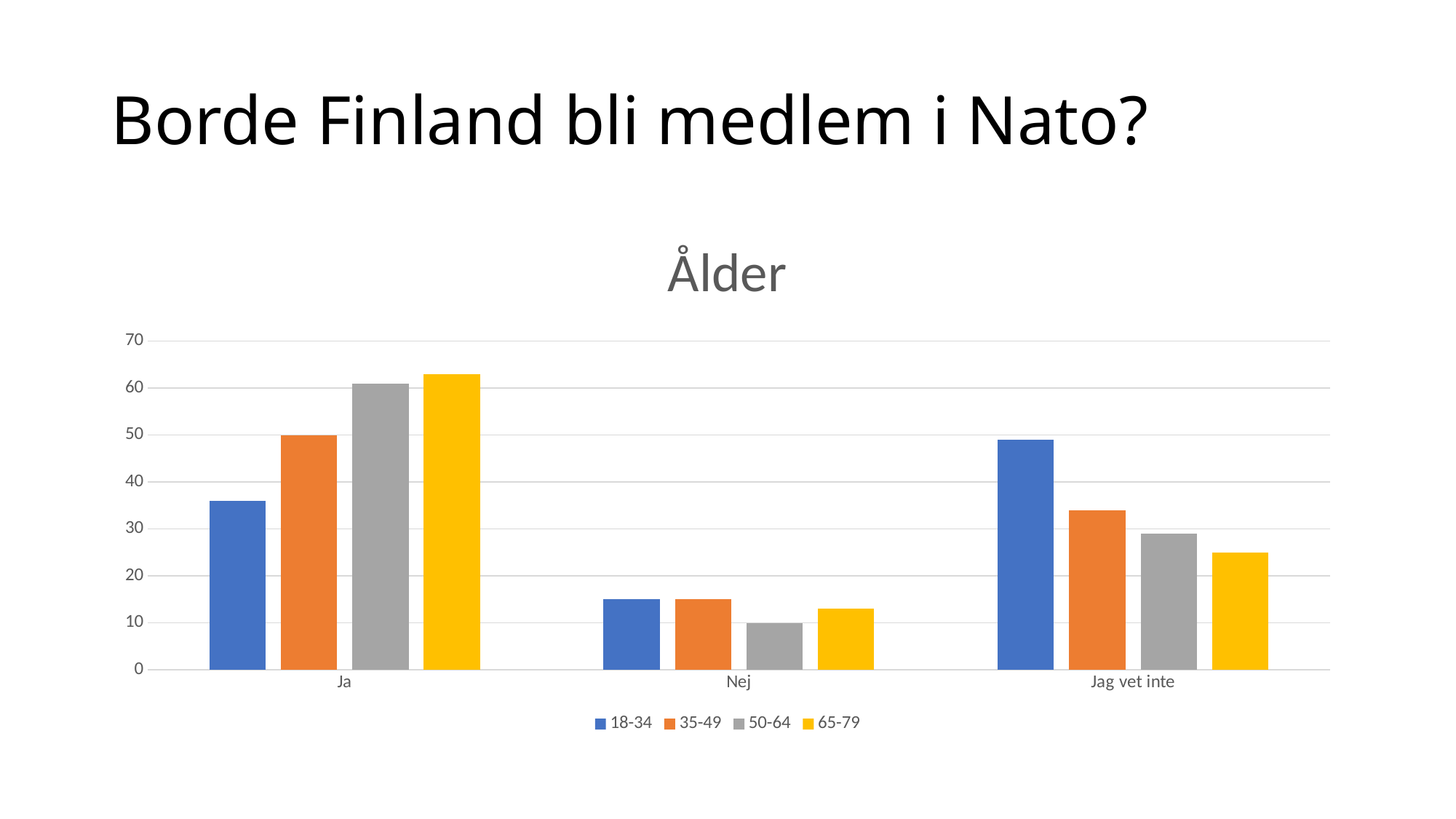
Which age group has the highest value in the Jag vet inte category? 18-34 Is the value for the 18-34 series in the Jag vet inte category greater or less than 40? greater Is the value for the 65-79 series in the Nej category greater or less than 20? less What is the value for the 50-64 series in the Nej category? 10 Which age group has the highest value in the Ja category? 65-79 In the Jag vet inte category, which is larger: the value for 35-49 or the value for 65-79? 35-49 How many series does the legend list? 4 How many categories are shown on the x axis? 3 What is the title of the chart? Ålder What is the value for the 35-49 series in the Ja category? 50 What kind of chart is shown on the slide? bar chart Which age group has the lowest value in the Ja category? 18-34